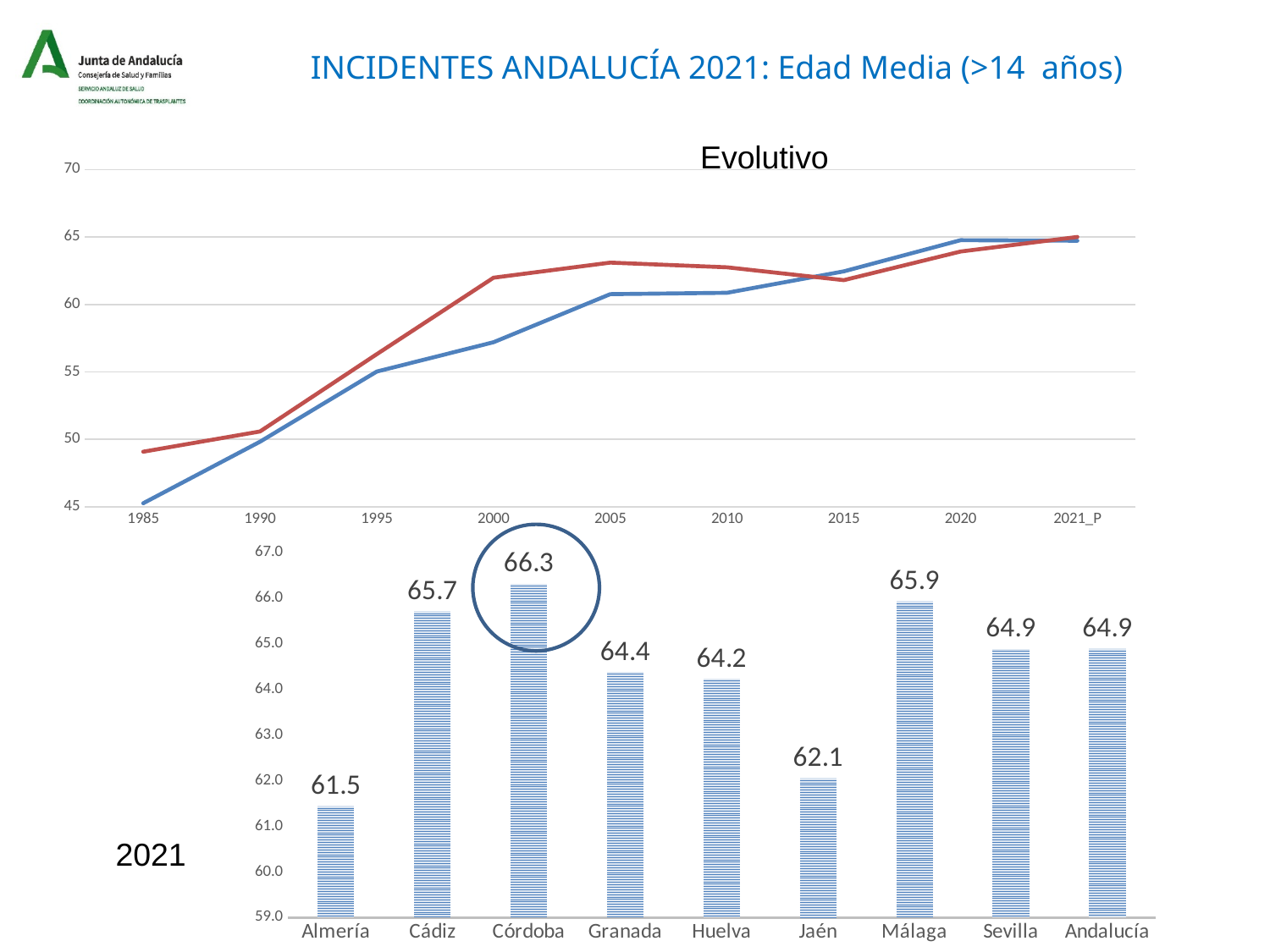
In the Evolutivo line chart, is the value of the red line in 2000 greater or less than 60? greater In the 2021 bar chart, what is the value for Jaén? 62.1 In the 2021 bar chart, which category has the lowest value? Almería In the 2021 bar chart, what is the difference between the values for Córdoba and Almería? 4.8 In the 2021 bar chart, which is larger, the value for Cádiz or the value for Málaga? Málaga In the Evolutivo line chart, do the values generally rise or fall from 1985 to 2021_P? rise What kind of chart is the Evolutivo chart at the top of the slide? line chart In the Evolutivo line chart, is the value of the blue line in 1985 greater or less than 50? less In the 2021 bar chart, what is the value for Córdoba? 66.3 In the 2021 bar chart, how many categories are shown on the x axis? 9 In the 2021 bar chart, which province has the highest value? Córdoba In the 2021 bar chart, what is the value for Andalucía? 64.9